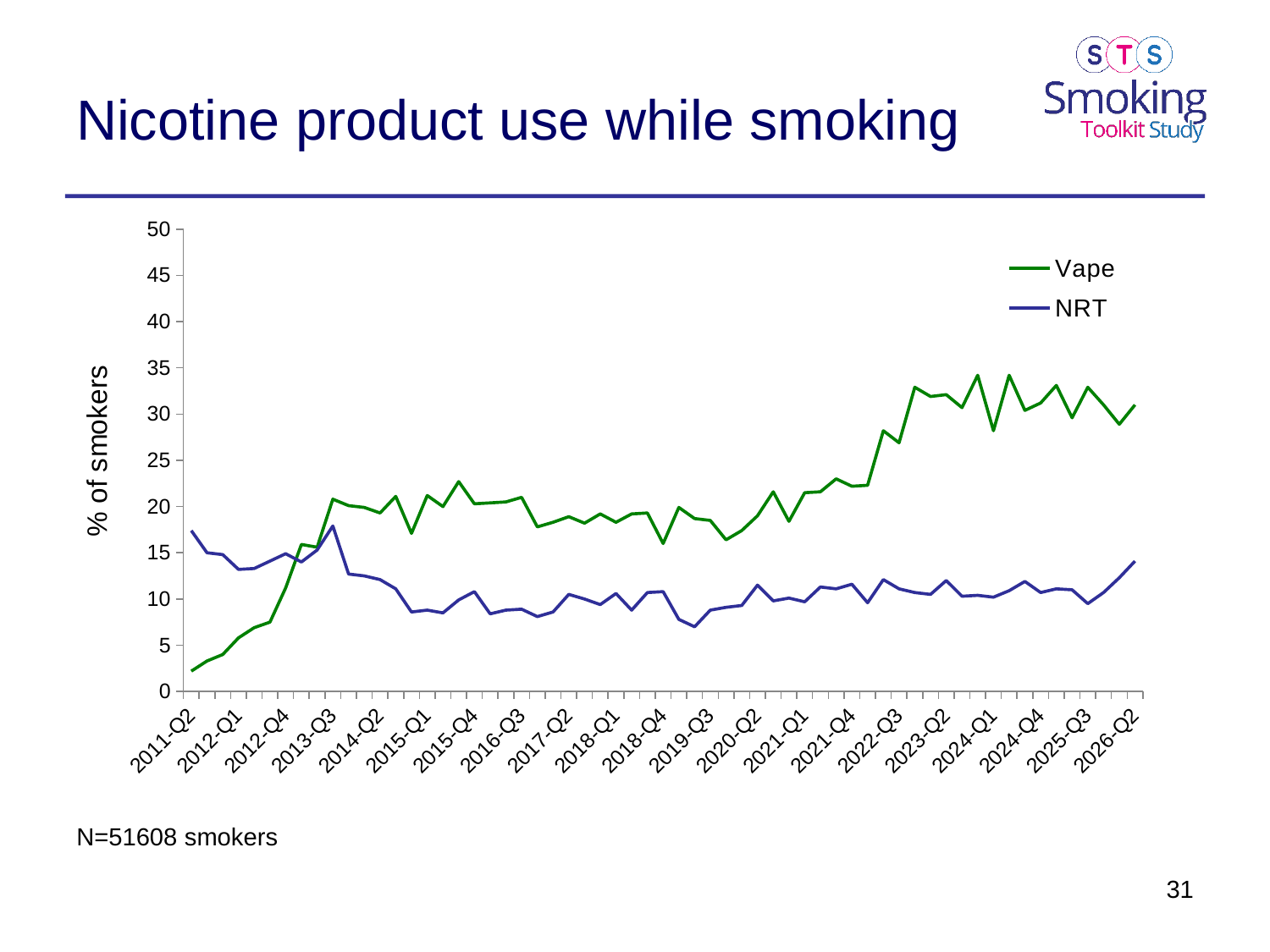
Does the NRT line overall rise or fall from 2011-Q2 to 2026-Q2? Fall Does the Vape line overall rise or fall from 2011-Q2 to 2026-Q2? Rise How many series does the legend list? 2 Is the value for NRT at 2011-Q2 greater or less than 15? greater Is the value for Vape at 2026-Q2 greater or less than 25? greater Which colour is used for the Vape line? Green Is the value for Vape at 2011-Q2 greater or less than 5? less At 2026-Q2, which series has the higher value, Vape or NRT? Vape What kind of chart is shown on the slide? Line chart At 2011-Q2, which series has the higher value, Vape or NRT? NRT What is the label on the vertical axis of the chart? % of smokers